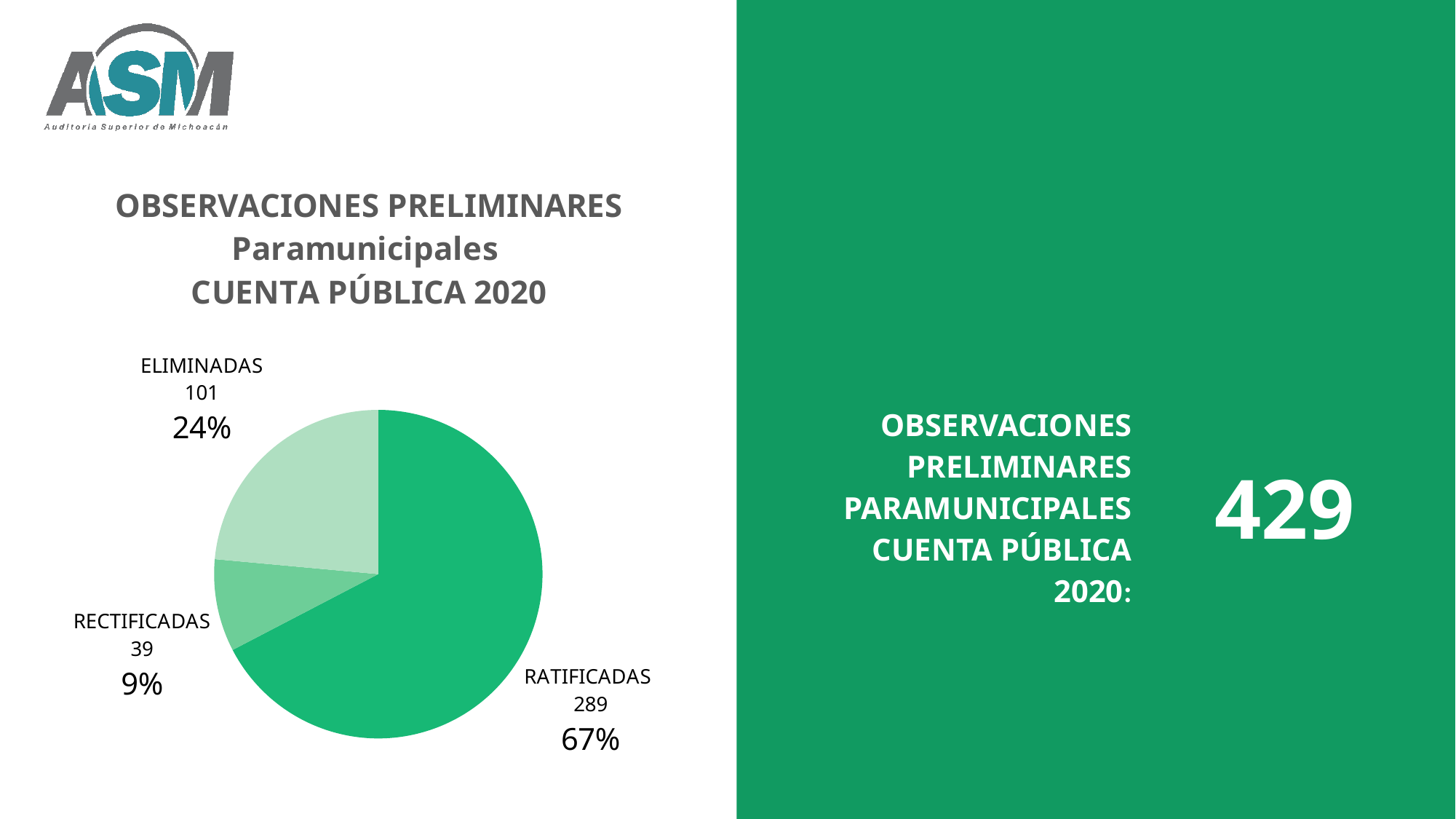
What is the value for RATIFICADAS? 289 What is the value for RECTIFICADAS? 39 What type of chart is shown on the slide? Pie chart What percentage share does RECTIFICADAS have? 9% What is the value for ELIMINADAS? 101 Which category has the smallest slice? RECTIFICADAS Which category has the largest slice? RATIFICADAS What percentage share does ELIMINADAS have? 24% What is the difference between the values for RATIFICADAS and ELIMINADAS? 188 How many slices does the pie chart have? 3 What percentage share does RATIFICADAS have? 67% What is the total of all three slices in the pie chart? 429